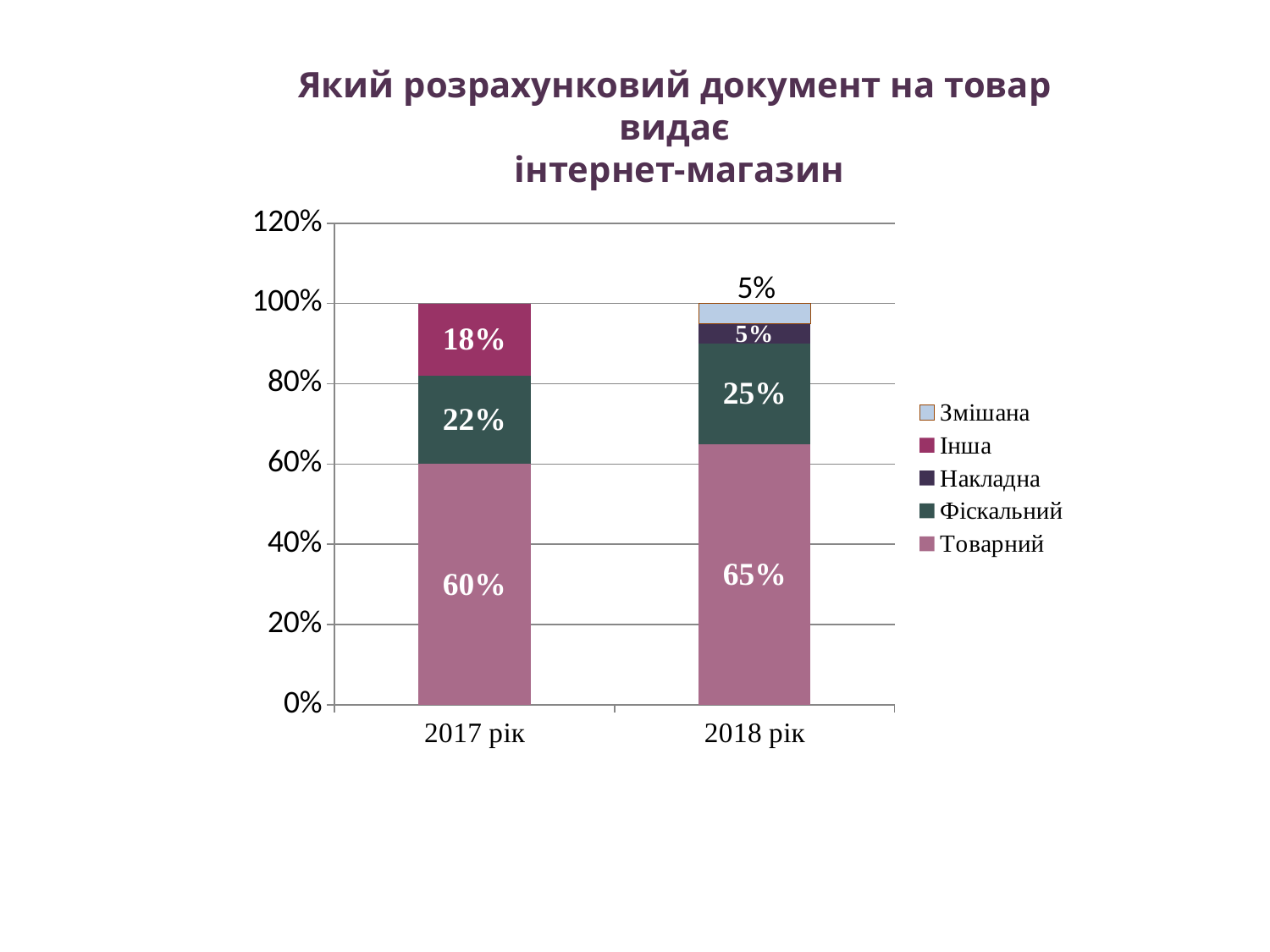
What is the value for Товарний in 2017 рік? 60% What type of chart is shown on the slide? Stacked bar chart Which year has the larger Фіскальний value, 2017 рік or 2018 рік? 2018 рік How many categories are shown on the x axis? 2 What is the value for Фіскальний in 2018 рік? 25% What is the value for Фіскальний in 2017 рік? 22% What is the value for Товарний in 2018 рік? 65% What is the value for Накладна in 2018 рік? 5% How many series does the legend list? 5 Which series is the largest segment in the 2017 рік bar? Товарний What is the value for Інша in 2017 рік? 18% What is the difference between the Товарний values for 2018 рік and 2017 рік? 5%